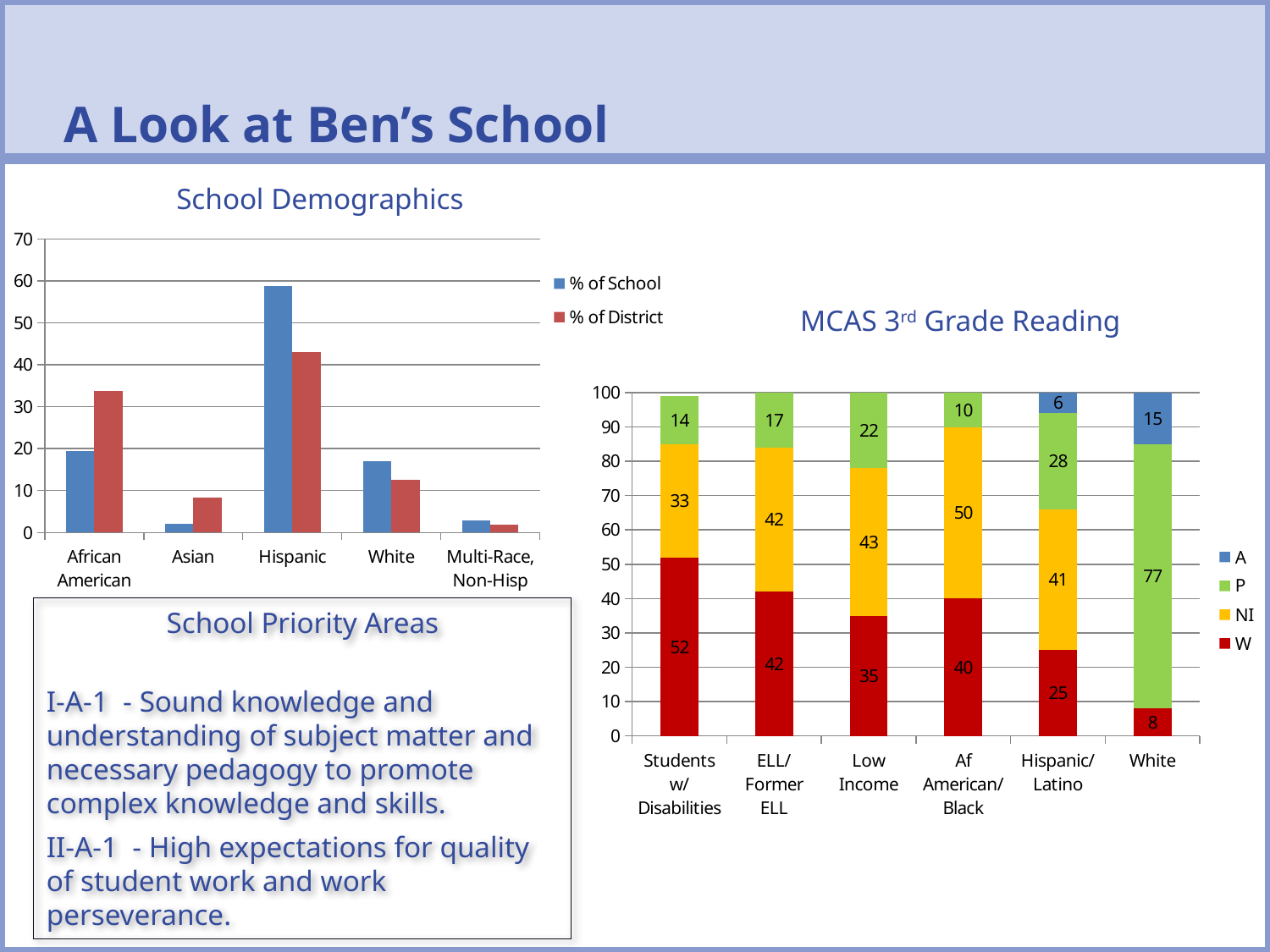
In the MCAS 3rd Grade Reading chart, which category has the highest W value? Students w/ Disabilities In the MCAS 3rd Grade Reading chart, what is the NI value for Af American/Black? 50 What kind of chart is the School Demographics chart? bar chart In the School Demographics chart, is the % of District value for African American greater or less than 30? greater In the MCAS 3rd Grade Reading chart, what is the difference between the NI value for Low Income and the NI value for ELL/Former ELL? 1 In the MCAS 3rd Grade Reading chart, what is the P value for White? 77 In the MCAS 3rd Grade Reading chart, what is the W value for Students w/ Disabilities? 52 In the MCAS 3rd Grade Reading chart, which category has the lowest W value? White In the School Demographics chart, which category has the highest % of School value? Hispanic How many series does the legend of the MCAS 3rd Grade Reading chart list? 4 In the MCAS 3rd Grade Reading chart, which has the larger P value, Hispanic/Latino or Low Income? Hispanic/Latino In the MCAS 3rd Grade Reading chart, what is the A value for Hispanic/Latino? 6